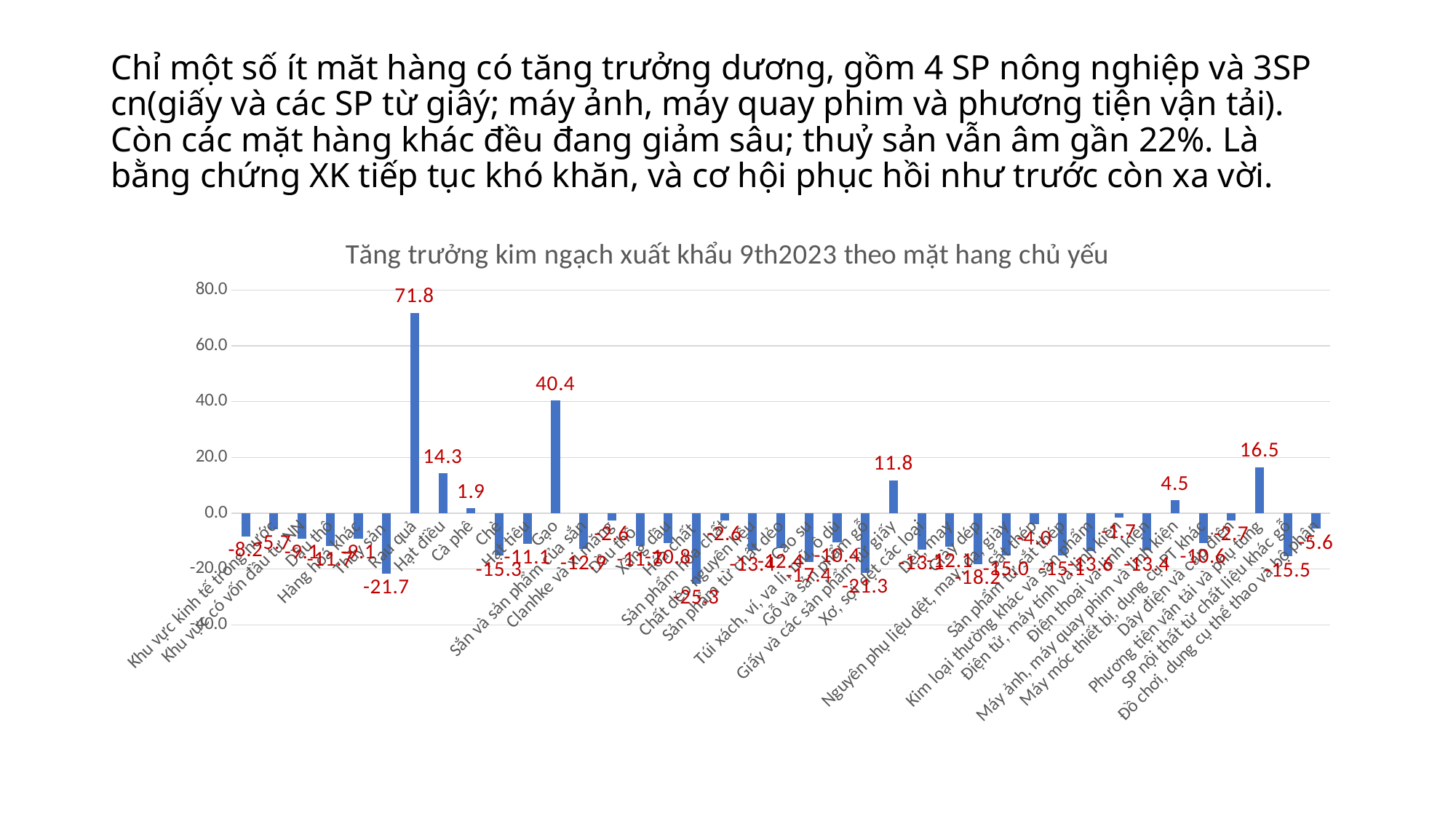
What is the value for Thuỷ sản? -21.7 What is the value for Rau quả? 71.8 What is the difference between the values for Rau quả and Gạo? 31.4 What is the value for Gạo? 40.4 What kind of chart is shown on the slide? bar chart What is the value for Cà phê? 1.9 Is the value for Rau quả greater or less than 60? greater What is the value for Hạt điều? 14.3 Which is larger, the value for Gạo or the value for Hạt điều? Gạo What is the value for Phương tiện vận tải và phụ tùng? 16.5 Which category has the highest value? Rau quả What is the title of the chart? Tăng trưởng kim ngạch xuất khẩu 9th2023 theo mặt hang chủ yếu